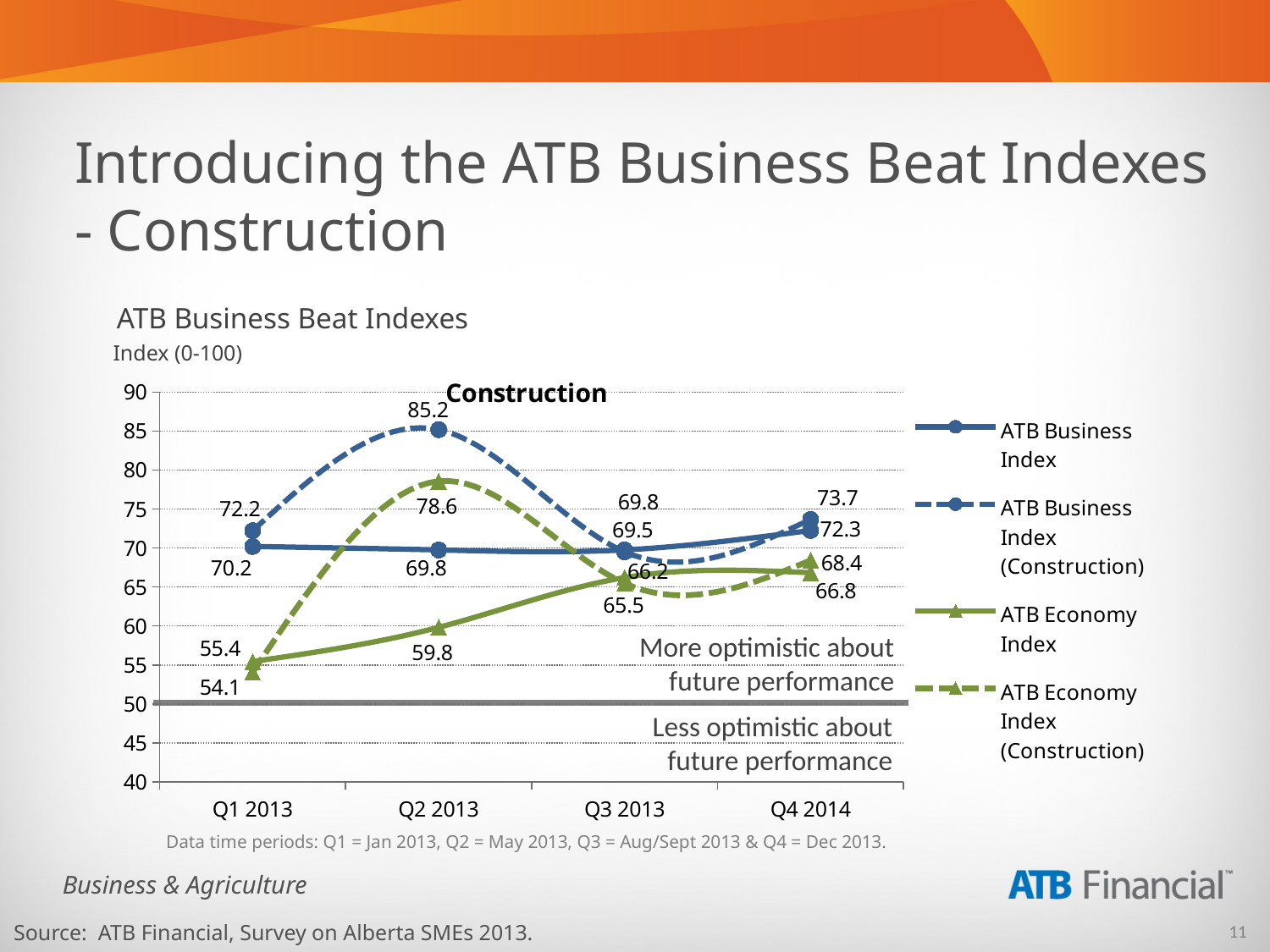
How many series does the legend list? 4 In which period is the ATB Economy Index lowest? Q1 2013 In which period is the ATB Business Index (Construction) highest? Q2 2013 By how much did the ATB Business Index (Construction) fall from Q2 2013 to Q3 2013? 15.7 How many time periods are shown on the x axis? 4 What is the value of the ATB Business Index (Construction) in Q2 2013? 85.2 What kind of chart is shown on the slide? line chart What is the value of the ATB Business Index in Q4 2014? 72.3 What is the value of the ATB Economy Index in Q1 2013? 55.4 Does the ATB Economy Index rise or fall from Q1 2013 to Q4 2014? rise At what index value is the horizontal line separating 'more optimistic' from 'less optimistic' drawn? 50 In Q4 2014, which is larger: the ATB Business Index (Construction) or the ATB Business Index? ATB Business Index (Construction)